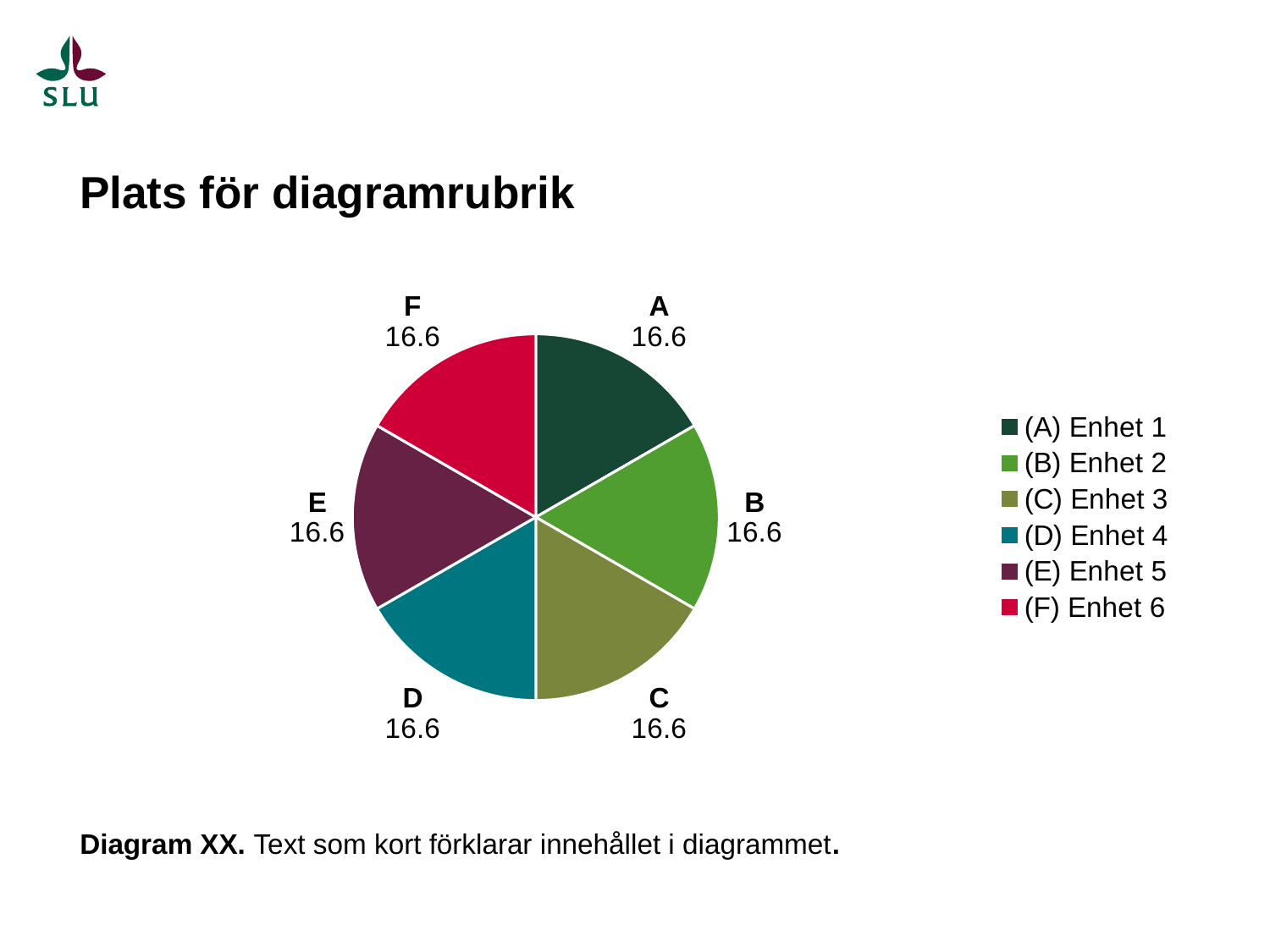
Do slices A and C have the same value? yes What is the difference between the values for slice B and slice E? 0 How many entries does the legend list? 6 What is the value shown for slice D? 16.6 What is the value shown for slice F? 16.6 How many slices does the pie chart have? 6 What is the legend entry for slice D? (D) Enhet 4 What is the title of the chart? Plats för diagramrubrik What kind of chart is shown on the slide? pie chart What is the value shown for slice A? 16.6